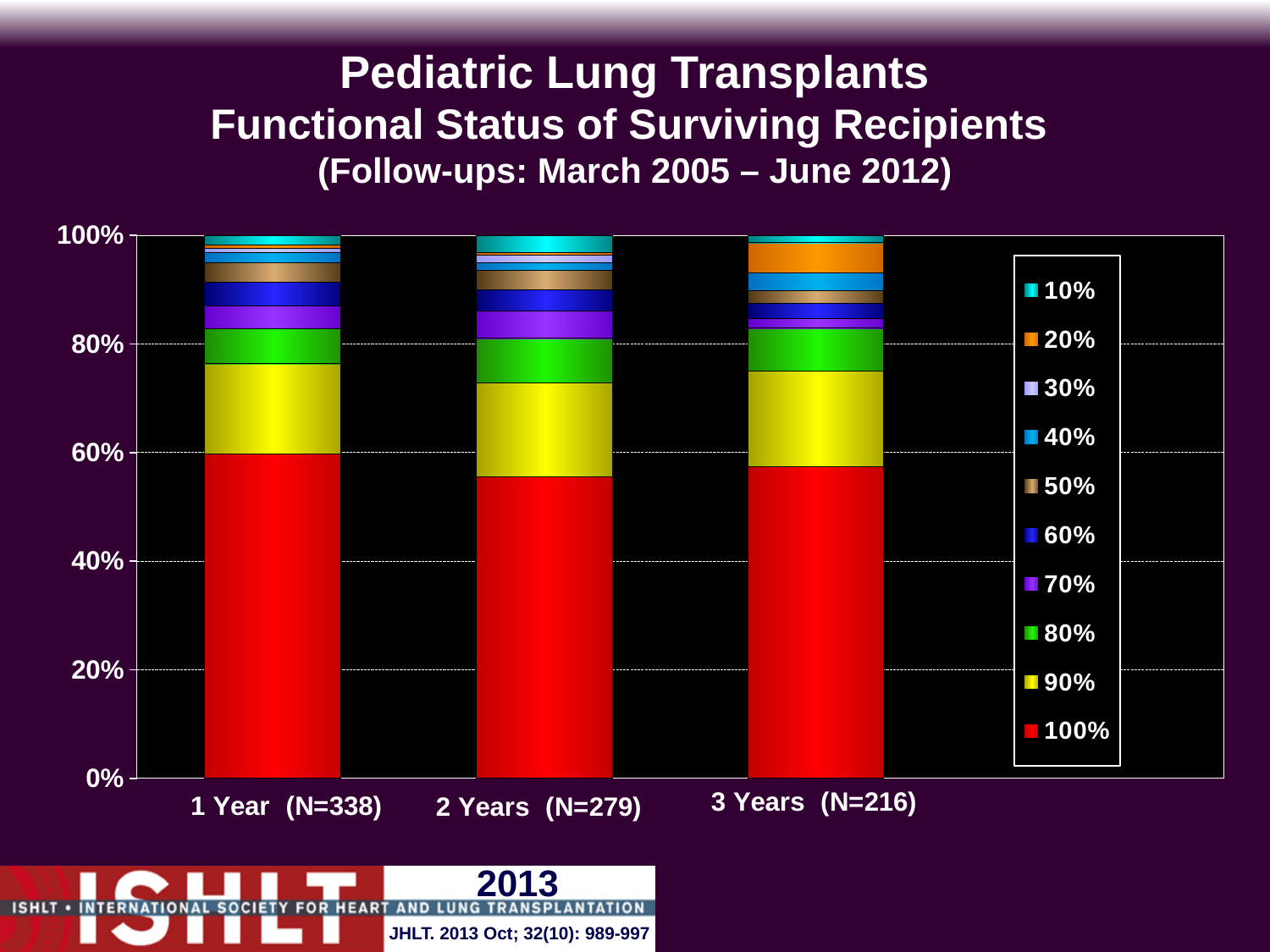
Which has the larger 100% functional status segment, 1 Year (N=338) or 2 Years (N=279)? 1 Year (N=338) Is the 100% functional status segment for 3 Years (N=216) greater or less than 60%? less Is the 100% functional status segment for 2 Years (N=279) greater or less than 60%? less What is the total height of the stacked bar for 1 Year (N=338)? 100% Which colour represents the 100% functional status series in the legend? Red What kind of chart is shown on the slide? Stacked bar chart How many follow-up categories are plotted on the x axis? 3 How many series does the legend list? 10 What is the sample size shown for the 3 Years category? N=216 Is the 100% functional status segment for 2 Years (N=279) greater or less than 40%? greater